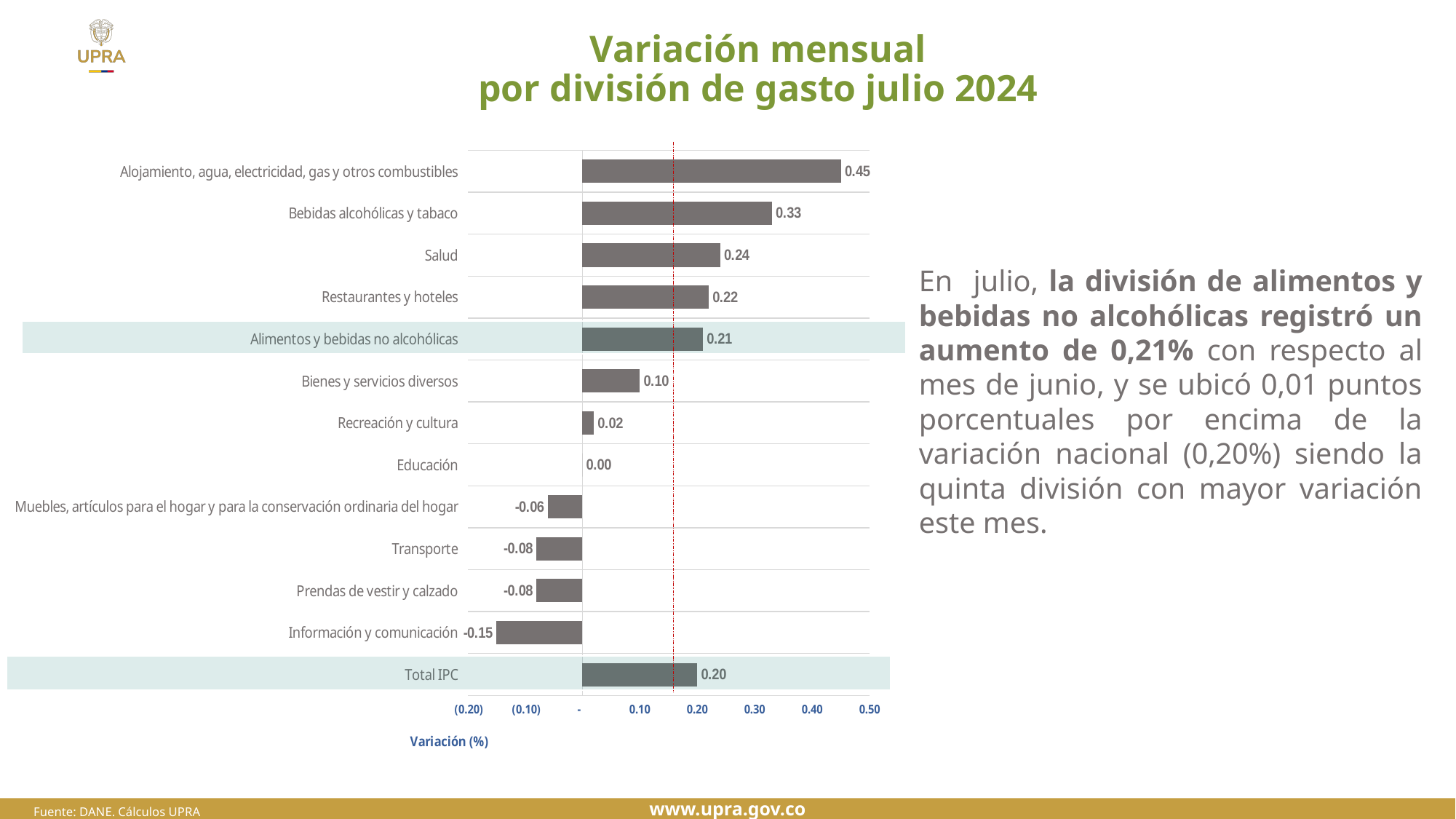
Which category has the lowest value? Información y comunicación What is the difference between the values for Alojamiento, agua, electricidad, gas y otros combustibles and Bebidas alcohólicas y tabaco? 0.12 What is the value for Alimentos y bebidas no alcohólicas? 0.21 Which category has the highest value? Alojamiento, agua, electricidad, gas y otros combustibles What is the value for Total IPC? 0.20 What is the title of the chart? Variación mensual por división de gasto julio 2024 How many categories are shown in the chart? 13 What is the value for Información y comunicación? -0.15 Which is larger, the value for Salud or the value for Restaurantes y hoteles? Salud What is the value for Alojamiento, agua, electricidad, gas y otros combustibles? 0.45 What is the label of the horizontal axis? Variación (%) What kind of chart is shown on the slide? Bar chart